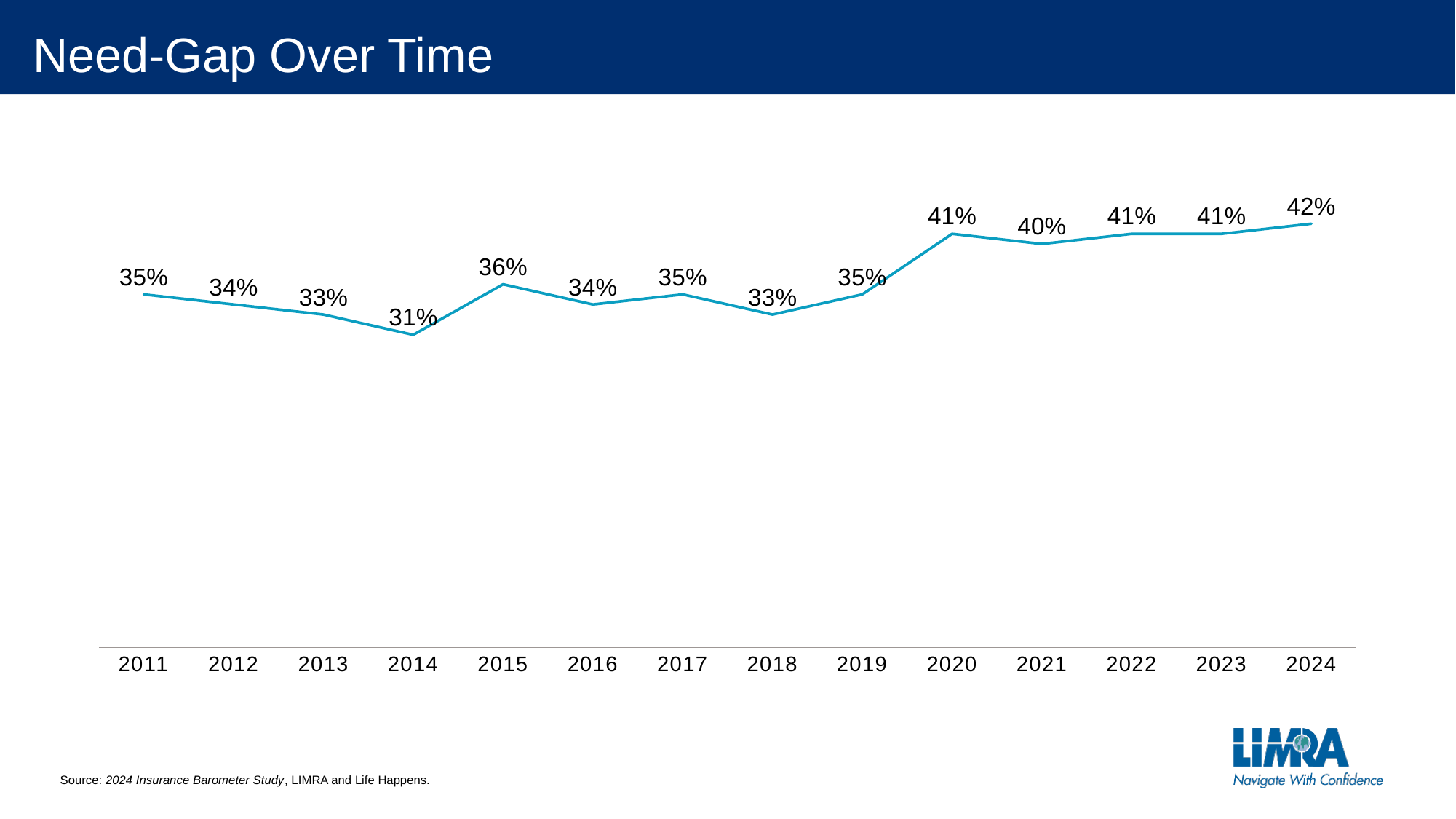
What is the difference between the need-gap values for 2020 and 2019? 6% What is the difference between the need-gap values for 2024 and 2011? 7% What is the need-gap value for 2024? 42% What is the need-gap value for 2014? 31% What kind of chart is shown on the slide? Line chart What is the title of the chart on the slide? Need-Gap Over Time Overall, does the need-gap value rise or fall from 2011 to 2024? Rise Which year has a larger need-gap value, 2015 or 2018? 2015 Which year has the lowest need-gap value? 2014 How many years are plotted on the chart? 14 Which year has the highest need-gap value? 2024 What is the need-gap value for 2020? 41%